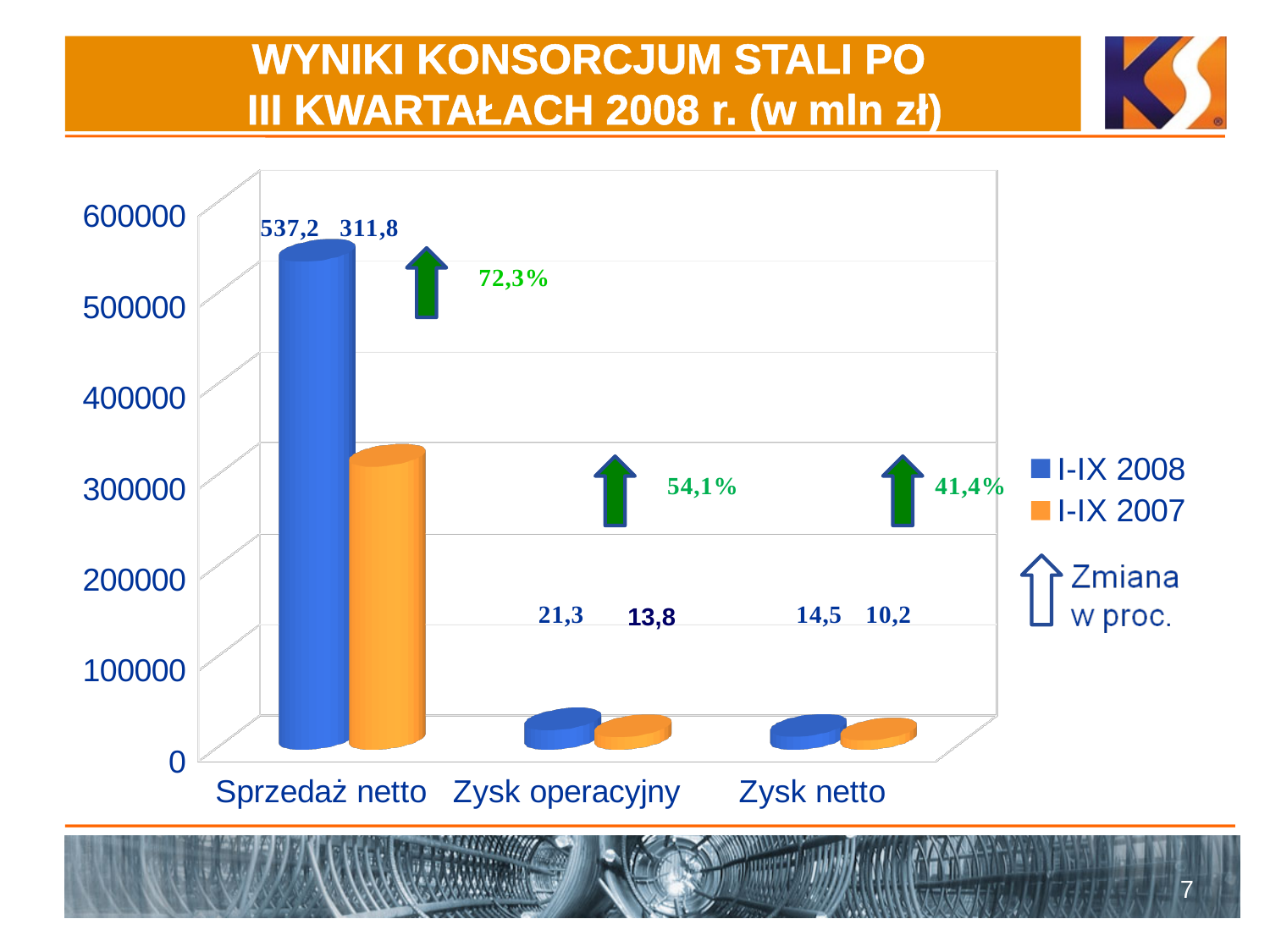
Which category has the highest value for I-IX 2008? Sprzedaż netto How many data series does the legend list? 2 What is the value of Zysk netto for I-IX 2007? 10,2 What is the value of Sprzedaż netto for I-IX 2007? 311,8 What type of chart is shown on the slide? bar chart What percentage change is shown for Zysk operacyjny? 54,1% Which is larger for Zysk netto: the I-IX 2008 value or the I-IX 2007 value? I-IX 2008 What is the value of Sprzedaż netto for I-IX 2008? 537,2 Which category has the lowest value for I-IX 2007? Zysk netto What is the value of Zysk operacyjny for I-IX 2008? 21,3 How many categories are shown on the x axis? 3 What is the difference between the I-IX 2008 and I-IX 2007 values for Sprzedaż netto? 225,4